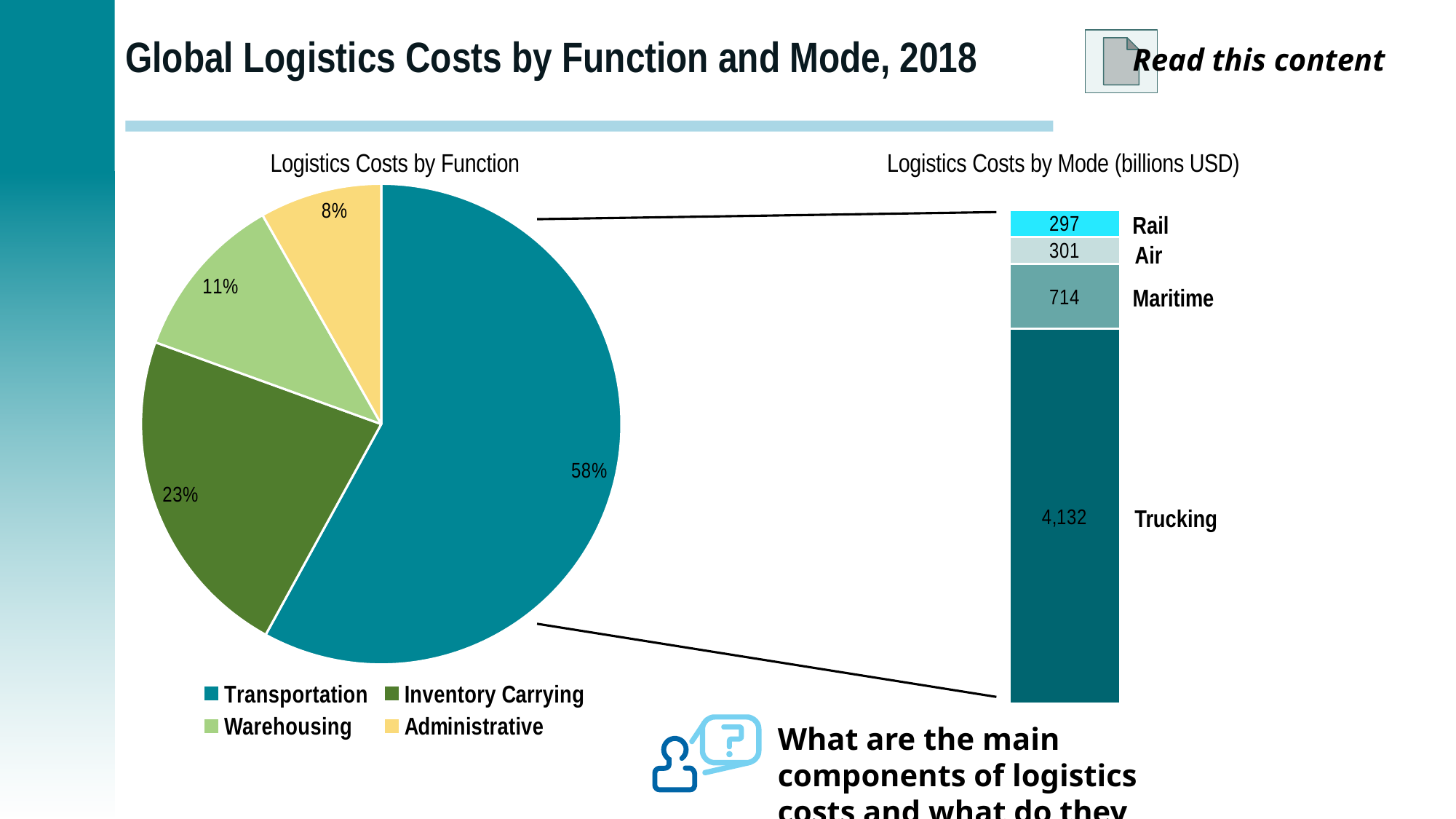
In the Logistics Costs by Function chart, which function has the smallest share? Administrative In the Logistics Costs by Function chart, what is the difference in percentage points between Warehousing and Administrative? 3 In the Logistics Costs by Mode chart, what is the value for Maritime? 714 In the Logistics Costs by Function chart, what share of costs is Inventory Carrying? 23% In the Logistics Costs by Function chart, how many categories does the legend list? 4 In the Logistics Costs by Function chart, which colour represents Warehousing? Light green What kind of chart is Logistics Costs by Function? Pie chart In the Logistics Costs by Mode chart, which mode has the lowest value? Rail In the Logistics Costs by Mode chart, what is the difference between Trucking and Maritime? 3,418 In the Logistics Costs by Mode chart, what is the value for Trucking? 4,132 In the Logistics Costs by Mode chart, what is the total of all four modes in the stacked bar? 5,444 In the Logistics Costs by Function chart, what share of costs is Transportation? 58%